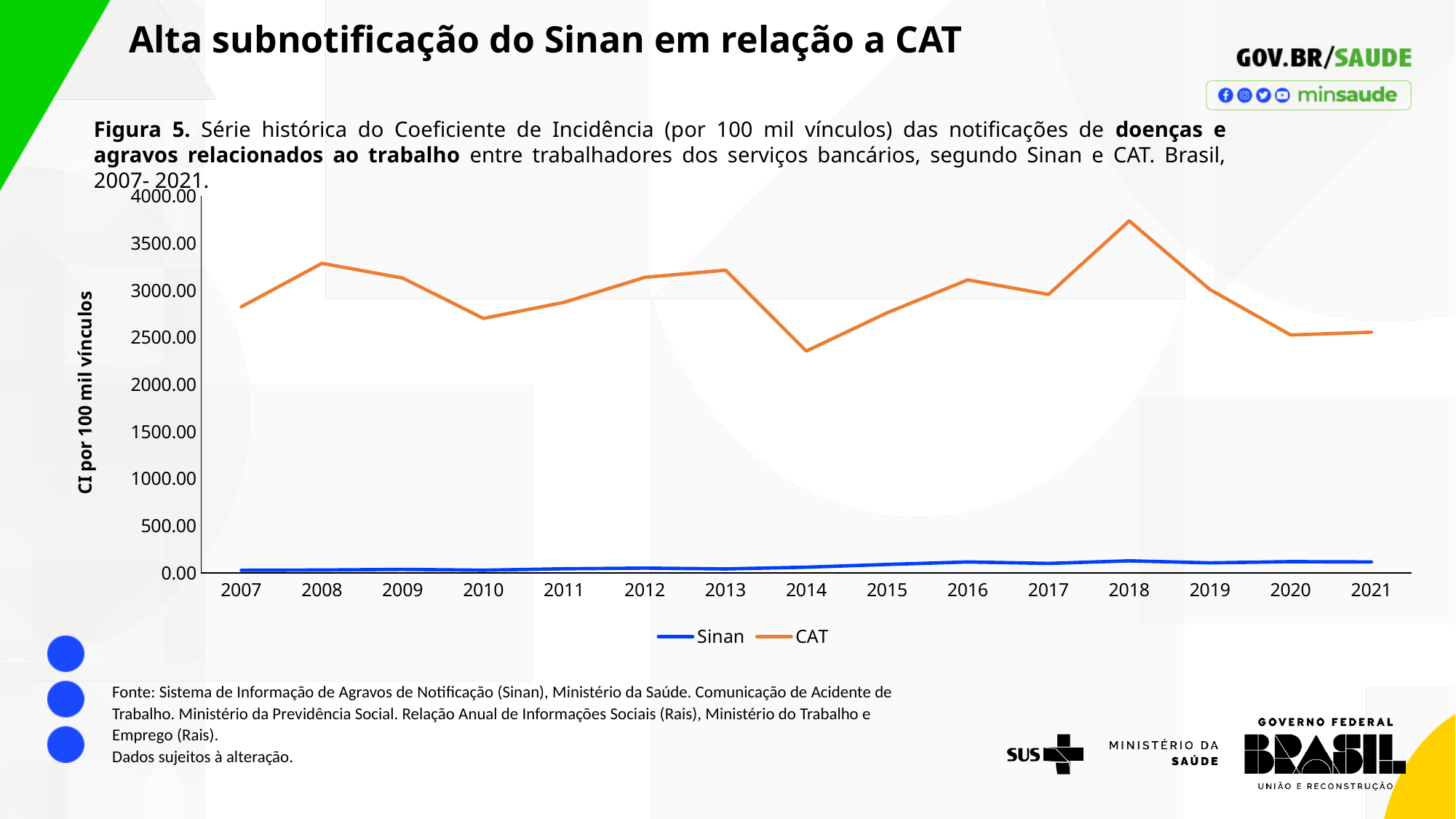
How many years are plotted along the x axis? 15 In which year does the CAT series reach its highest value? 2018 Is the value for CAT in 2008 greater or less than 3000? greater Is the value for CAT in 2018 greater or less than 3500? greater Does the CAT series rise or fall from 2018 to 2020? fall In which year does the CAT series reach its lowest value? 2014 What colour is the line for the CAT series? orange Is the value for CAT in 2014 greater or less than 2500? less What kind of chart is shown on the slide? line chart Which series has the larger value in 2013, Sinan or CAT? CAT How many series does the legend list? 2